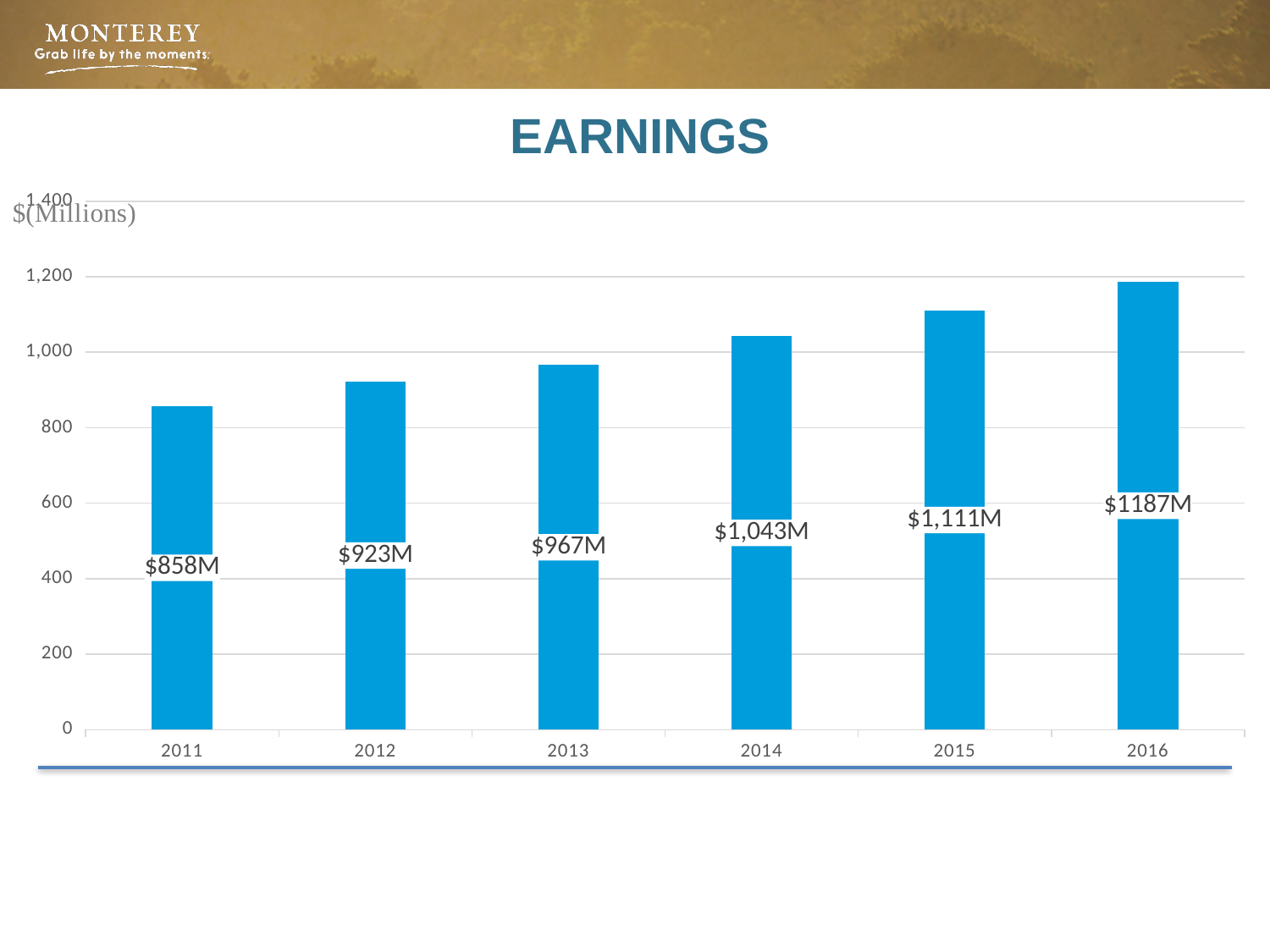
What kind of chart is shown on the slide? bar chart Which year has the highest earnings? 2016 Do earnings rise or fall from 2011 to 2016? rise How many years are shown on the chart? 6 What is the earnings value for 2016? $1187M What is the difference in earnings between 2016 and 2015? $76M What is the earnings value for 2014? $1,043M Is the value for 2013 greater or less than 1,000? less Which year has the lowest earnings? 2011 What is the difference in earnings between 2013 and 2012? $44M What is the earnings value for 2011? $858M Which year has higher earnings, 2014 or 2015? 2015